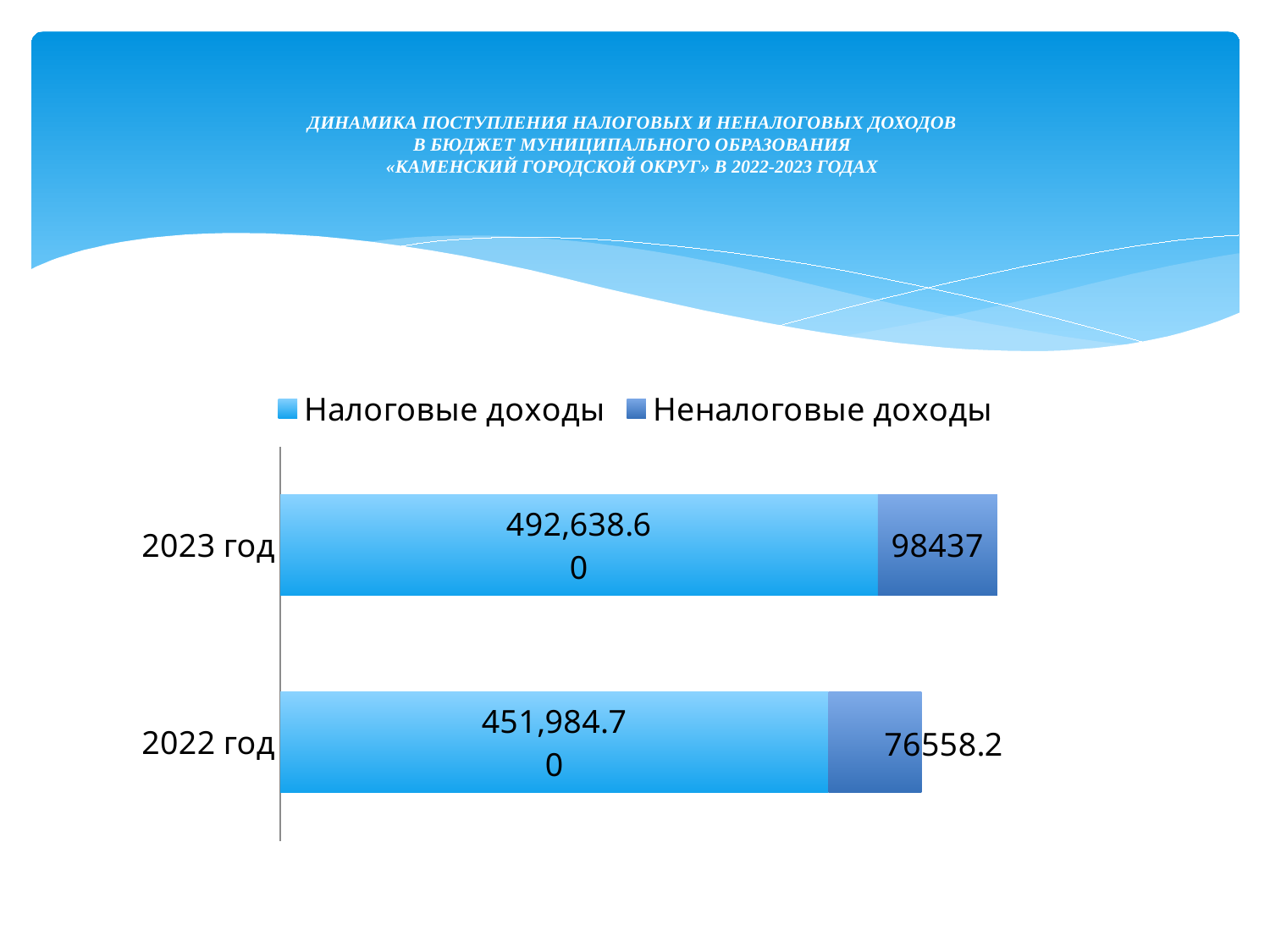
What is the total of the stacked bar for 2023 год? 591,075.60 What is the value of Налоговые доходы for 2023 год? 492,638.60 Which year has the higher value of Налоговые доходы? 2023 год How many series does the legend list? 2 By how much did Неналоговые доходы in 2023 год exceed those in 2022 год? 21878.8 How many categories (years) are shown on the chart? 2 What type of chart is shown on the slide? Stacked bar chart What is the value of Неналоговые доходы for 2022 год? 76558.2 Which series is shown in the darker blue colour in the legend? Неналоговые доходы Which year has the lower value of Неналоговые доходы? 2022 год What is the value of Неналоговые доходы for 2023 год? 98437 What is the value of Налоговые доходы for 2022 год? 451,984.70